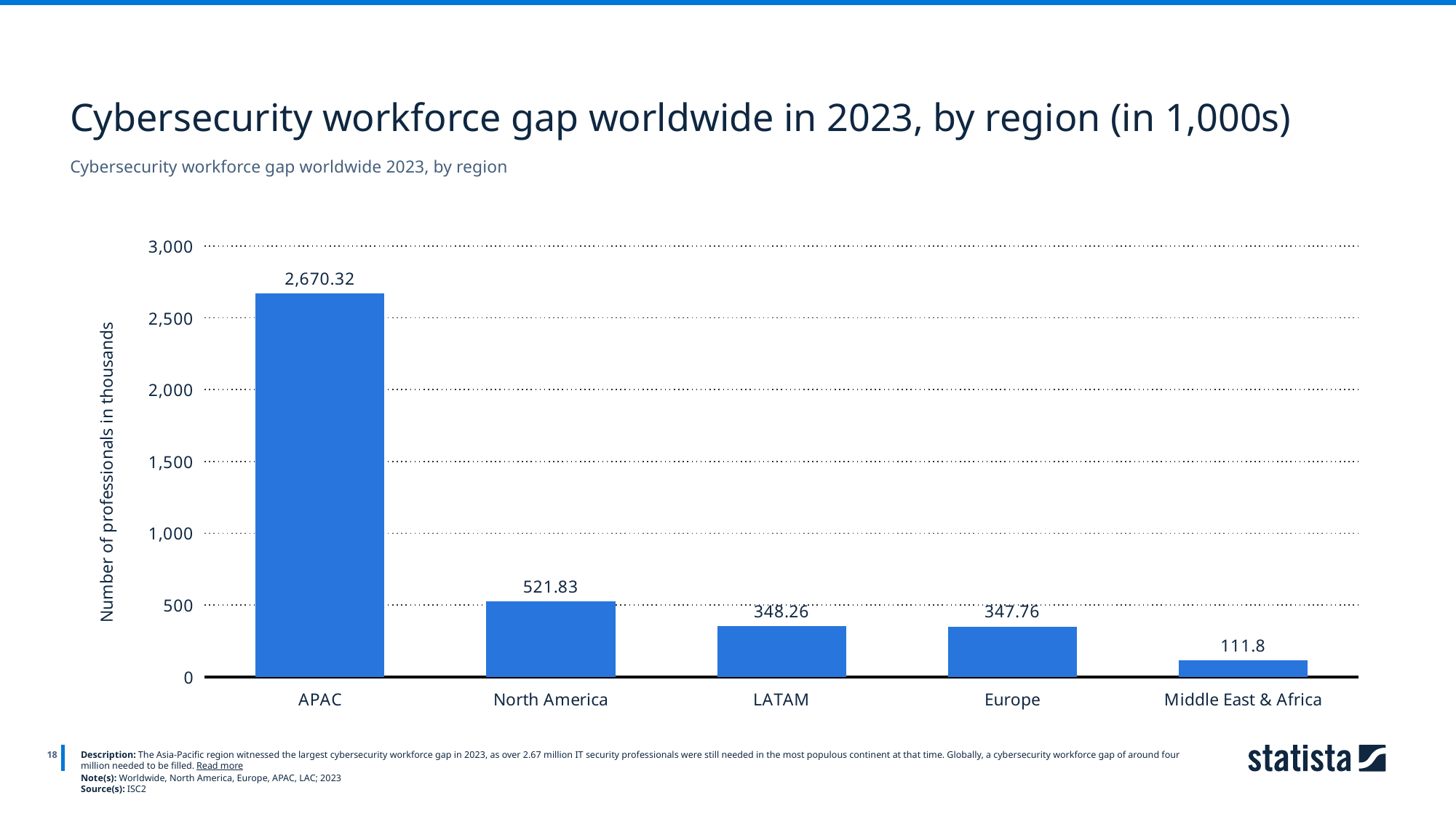
What is the label of the vertical axis? Number of professionals in thousands Which region has the largest cybersecurity workforce gap? APAC What is the cybersecurity workforce gap for APAC? 2,670.32 Is the value for North America greater or less than 500? greater Which has a larger workforce gap, North America or Europe? North America What is the cybersecurity workforce gap for North America? 521.83 Which region has the smallest cybersecurity workforce gap? Middle East & Africa What is the difference between the workforce gap for APAC and North America? 2,148.49 What is the cybersecurity workforce gap for Middle East & Africa? 111.8 What is the cybersecurity workforce gap for LATAM? 348.26 How many regions are shown in the chart? 5 What kind of chart is shown on the slide? Bar chart